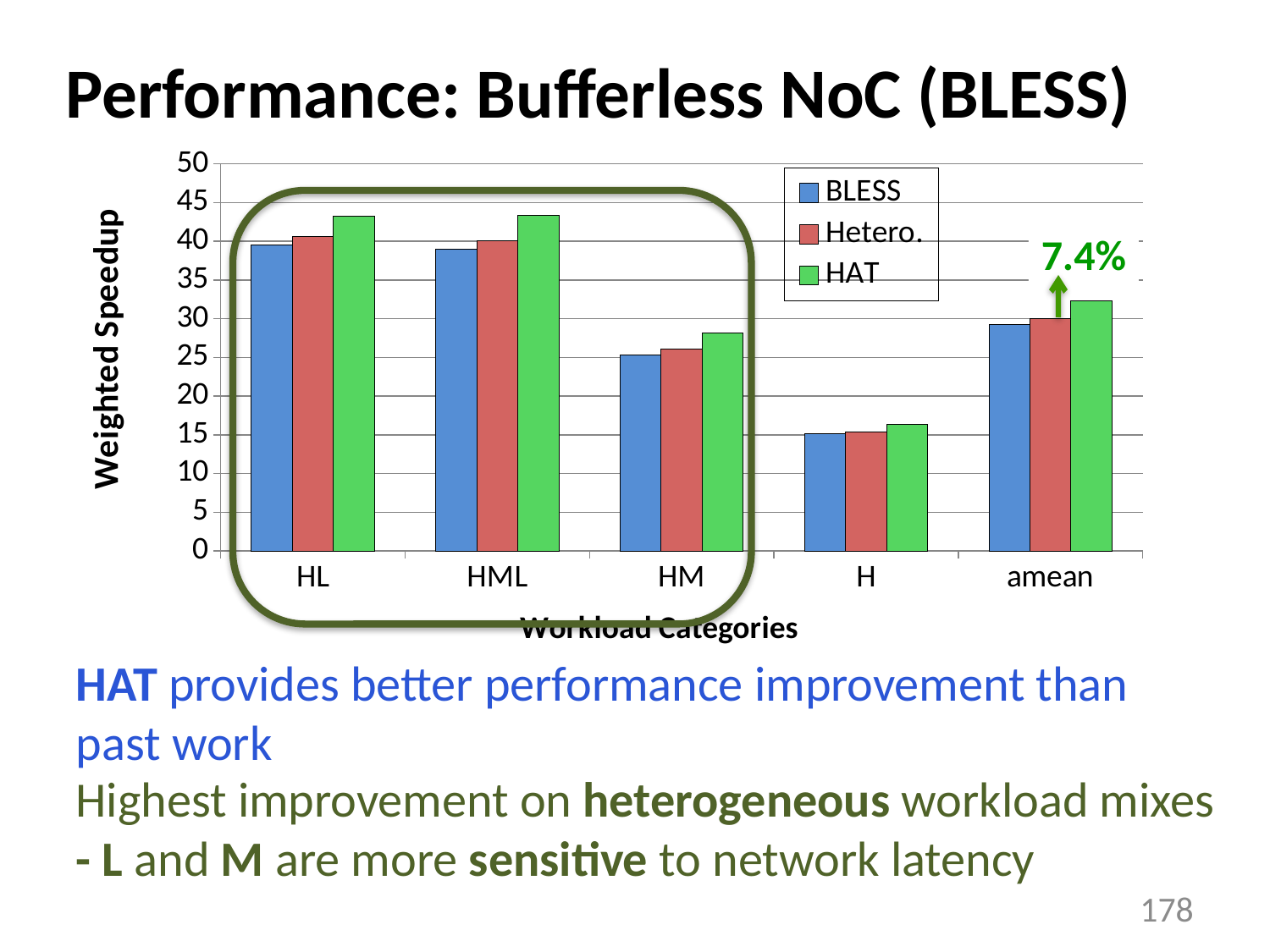
Is the HAT value for HM greater or less than 25? greater What percentage improvement is annotated above the amean bars? 7.4% Which workload category has the lowest weighted speedup for BLESS? H Which workload category has the lowest weighted speedup for HAT? H For the BLESS series, which is larger: the value for HM or the value for H? HM Is the BLESS value for H greater or less than 20? less Is the BLESS value for HL greater or less than 35? greater For the HM category, which is larger: the BLESS value or the HAT value? HAT What kind of chart is shown on the slide? bar chart How many series does the legend list? 3 How many workload categories are shown on the x axis? 5